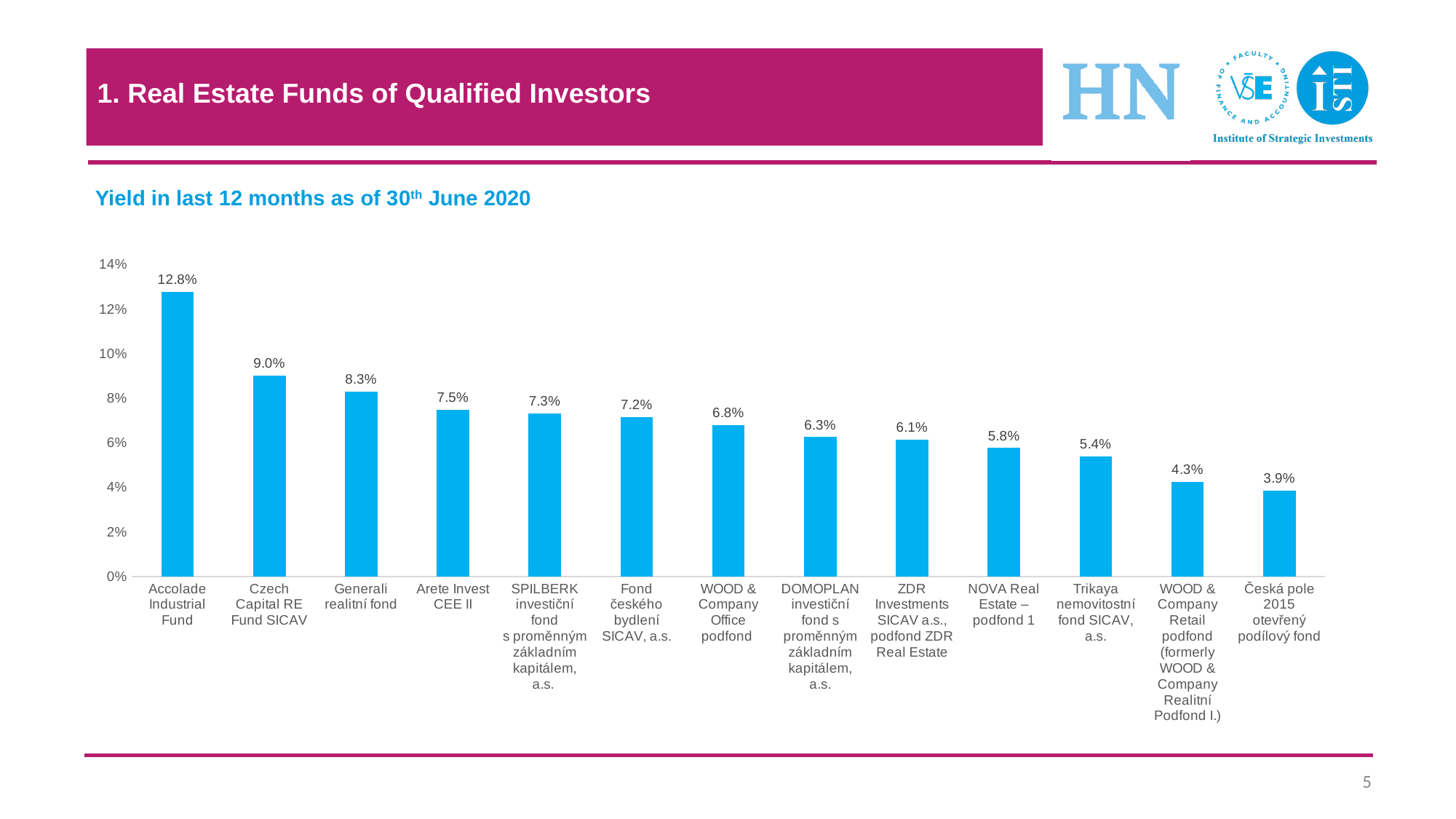
What is the yield for NOVA Real Estate – podfond 1? 5.8% Which fund has the lowest yield? Česká pole 2015 otevřený podílový fond How many funds are shown in the chart? 13 Do the yields rise or fall from left to right across the chart? Fall What type of chart is shown on the slide? Bar chart Which has a higher yield, Arete Invest CEE II or Trikaya nemovitostní fond SICAV, a.s.? Arete Invest CEE II Is the yield for WOOD & Company Office podfond greater or less than 6%? greater What is the difference in yield between Accolade Industrial Fund and Czech Capital RE Fund SICAV? 3.8% What is the yield for Generali realitní fond? 8.3% Which fund has the highest yield? Accolade Industrial Fund What is the yield for Accolade Industrial Fund? 12.8% What is the yield for Česká pole 2015 otevřený podílový fond? 3.9%